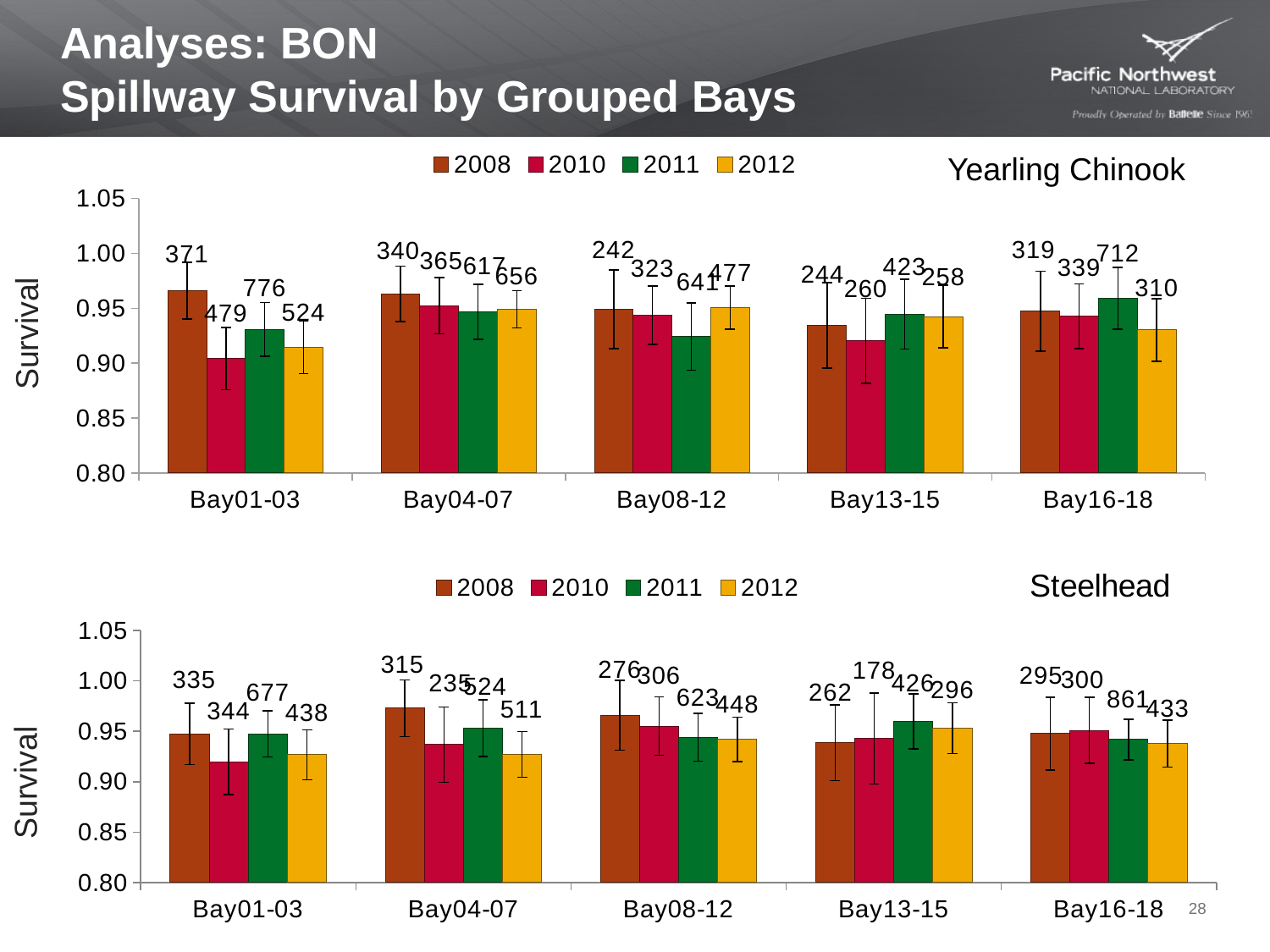
In the Steelhead chart, is the survival value for 2008 at Bay04-07 greater or less than 0.95? greater What are the legend entries of the Yearling Chinook chart? 2008, 2010, 2011, 2012 In the Yearling Chinook chart, which year has the highest survival for Bay01-03? 2008 In the Yearling Chinook chart, is the survival value for 2010 at Bay01-03 greater or less than 0.95? less In the Yearling Chinook chart, which year has the lowest survival for Bay01-03? 2010 In the Steelhead chart, which is larger for Bay04-07: the survival for 2008 or for 2010? 2008 How many series does the legend of the Steelhead chart list? 4 In the Yearling Chinook chart, is the survival value for 2011 at Bay08-12 greater or less than 0.95? less What kind of chart is the Yearling Chinook chart? bar chart How many bay groups are shown on the x axis of the Yearling Chinook chart? 5